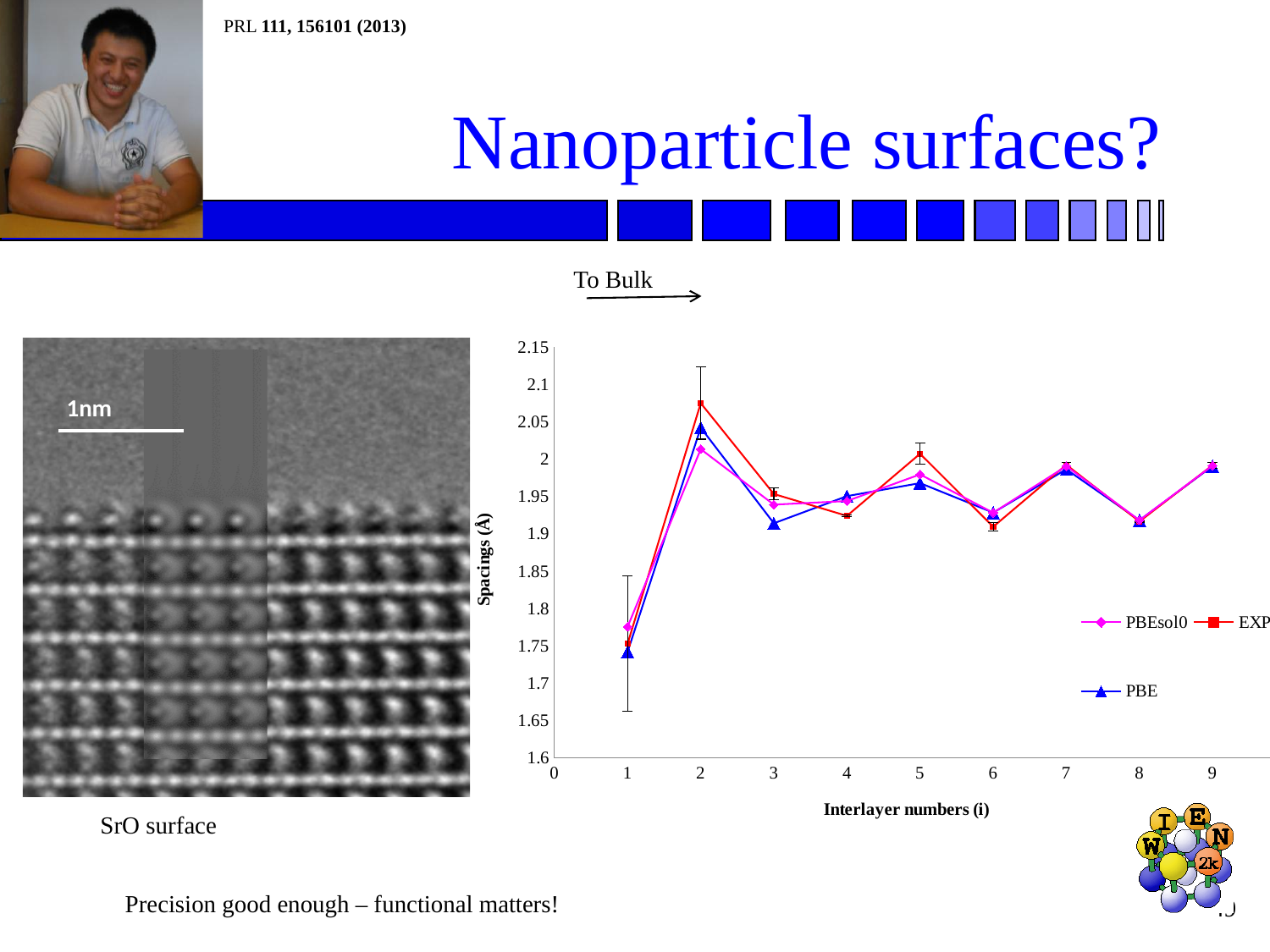
What kind of chart is shown on the slide? line chart Is the PBE spacing at interlayer number 1 greater or less than 1.8? less What is the title of the chart's vertical axis? Spacings (Å) Is the EXP spacing at interlayer number 2 greater or less than 2.05? greater At interlayer number 2, which series has the larger spacing, EXP or PBEsol0? EXP At which interlayer number does the EXP series have its lowest spacing? 1 At interlayer number 1, which series has the larger spacing, PBEsol0 or PBE? PBEsol0 How many interlayer numbers (data points per series) are plotted on the chart? 9 How many series does the chart legend list? 3 Is the PBE spacing at interlayer number 3 greater or less than 1.95? less Do the spacings rise or fall from interlayer number 1 to interlayer number 2? rise At which interlayer number does the EXP series reach its highest spacing? 2